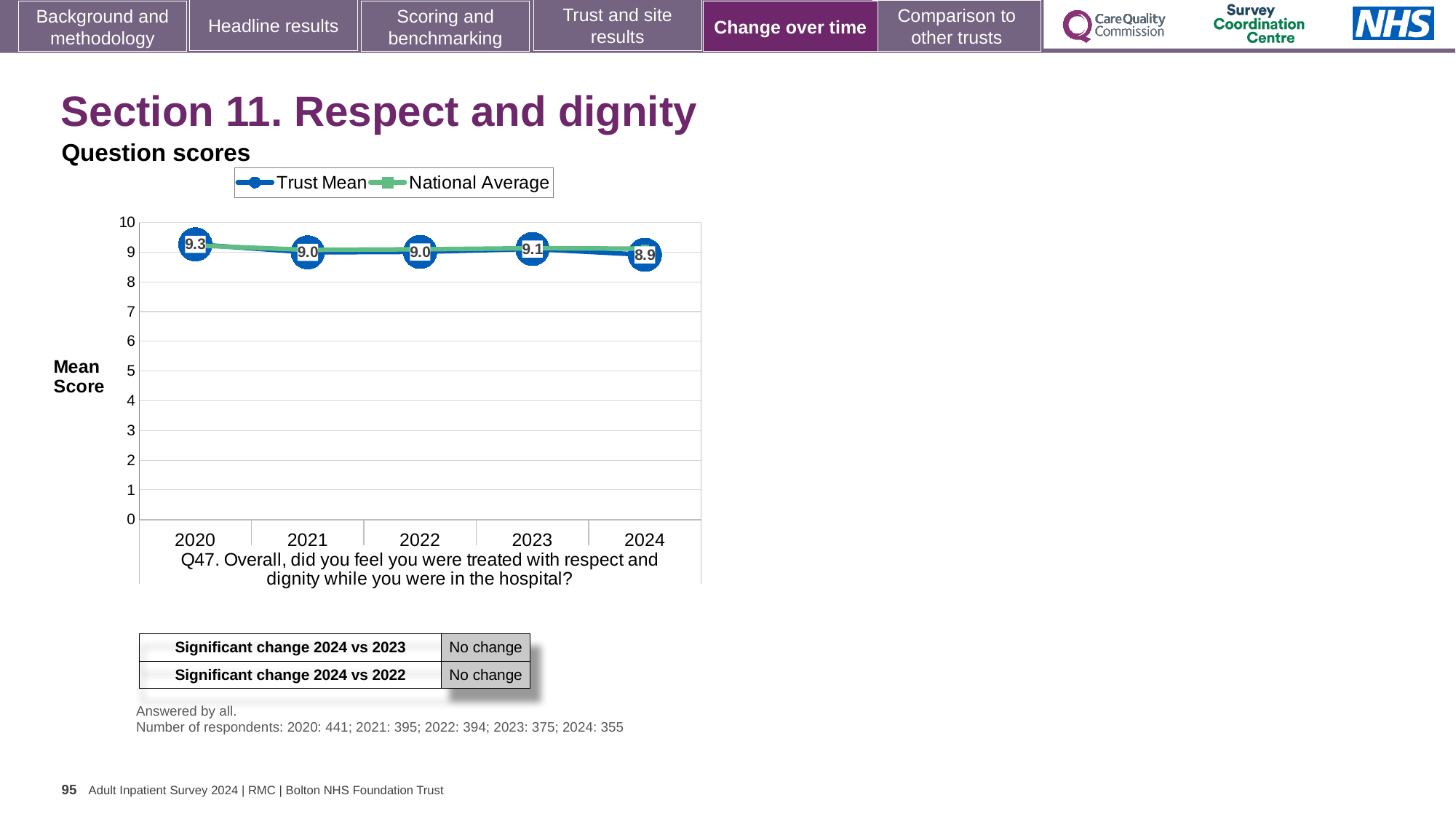
In which year is the Trust Mean score lowest? 2024 In which year is the Trust Mean score highest? 2020 Does the Trust Mean score rise or fall from 2020 to 2024? fall How many years are plotted on the x axis? 5 Which year has the larger Trust Mean score, 2023 or 2024? 2023 What kind of chart is shown on the slide? line chart What is the Trust Mean score for 2020? 9.3 Is the Trust Mean score for 2022 greater or less than 5? greater What is the Trust Mean score for 2024? 8.9 What is the Trust Mean score for 2023? 9.1 What is the difference between the Trust Mean scores for 2020 and 2024? 0.4 How many series does the legend list? 2